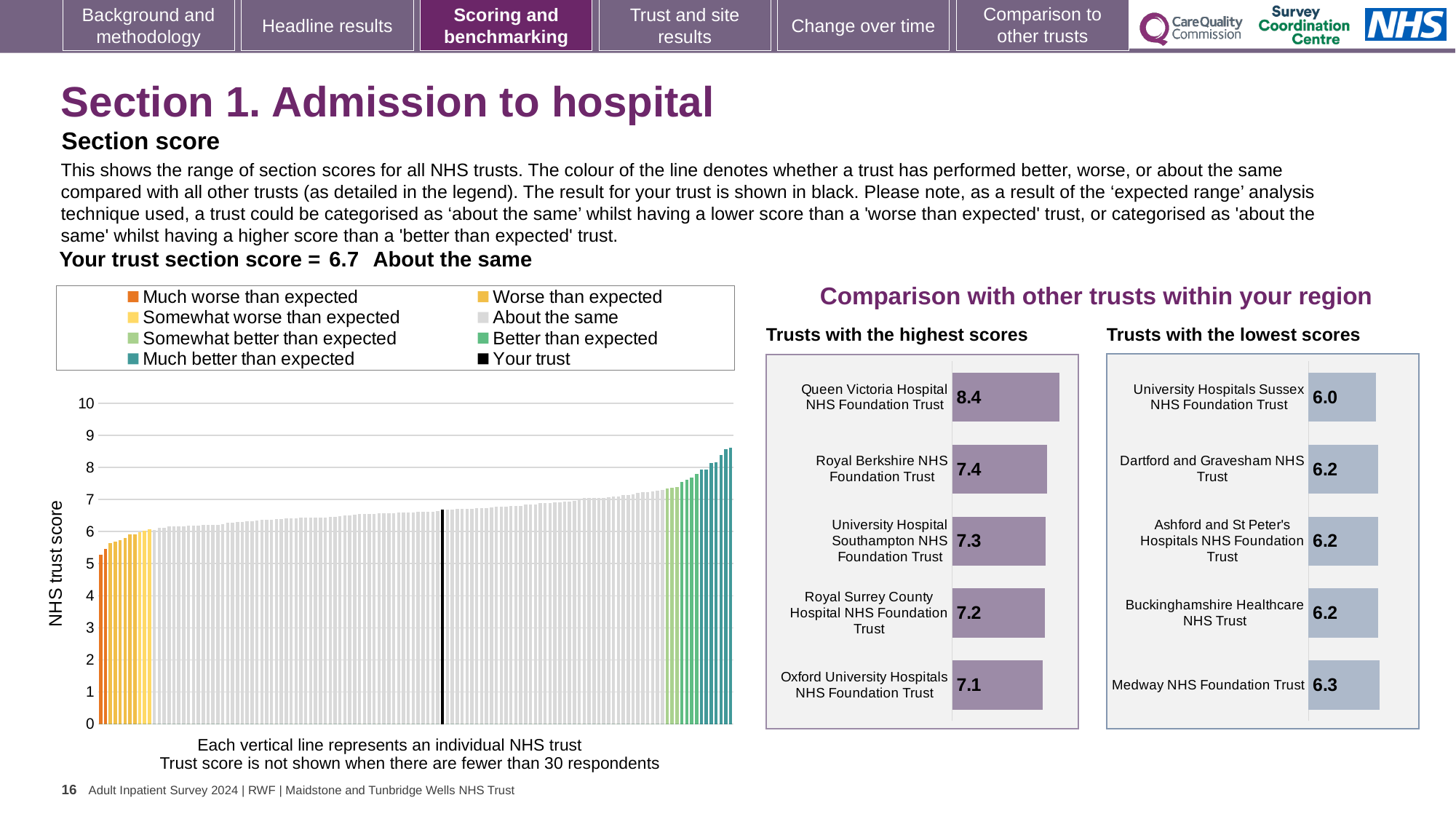
In the 'Trusts with the highest scores' chart, what is the score for Queen Victoria Hospital NHS Foundation Trust? 8.4 How many entries does the legend of the large chart on the left list? 8 In the large chart on the left, is the value of the tallest bar greater or less than 8? greater How many trusts are listed in the 'Trusts with the lowest scores' chart? 5 What kind of chart is the large chart on the left showing NHS trust scores? Bar chart In the 'Trusts with the highest scores' chart, what is the difference between the scores of Queen Victoria Hospital NHS Foundation Trust and Oxford University Hospitals NHS Foundation Trust? 1.3 In the 'Trusts with the highest scores' chart, which has the higher score: Royal Berkshire NHS Foundation Trust or Royal Surrey County Hospital NHS Foundation Trust? Royal Berkshire NHS Foundation Trust In the 'Trusts with the highest scores' chart, which trust has the highest score? Queen Victoria Hospital NHS Foundation Trust In the large chart on the left, do the NHS trust scores rise or fall from left to right? Rise In the 'Trusts with the lowest scores' chart, which trust has the lowest score? University Hospitals Sussex NHS Foundation Trust In the 'Trusts with the lowest scores' chart, what is the score for Dartford and Gravesham NHS Trust? 6.2 In the 'Trusts with the lowest scores' chart, what is the score for Medway NHS Foundation Trust? 6.3